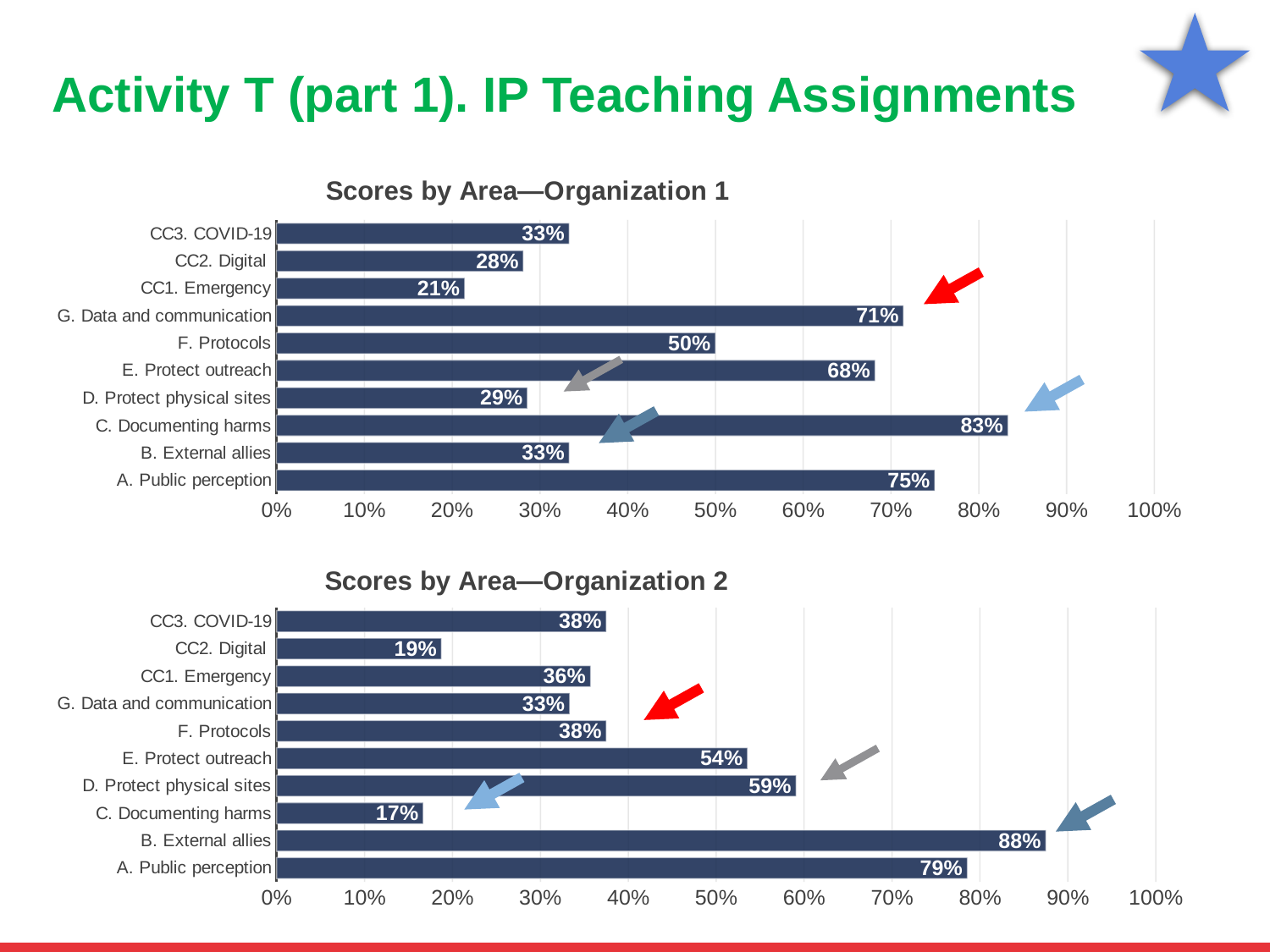
In the 'Scores by Area—Organization 2' chart, what is the value for D. Protect physical sites? 59% In the 'Scores by Area—Organization 2' chart, which is larger, E. Protect outreach or CC1. Emergency? E. Protect outreach In the 'Scores by Area—Organization 1' chart, what is the difference between A. Public perception and G. Data and communication? 4% In the 'Scores by Area—Organization 1' chart, which area has the highest score? C. Documenting harms In the 'Scores by Area—Organization 1' chart, which area has the lowest score? CC1. Emergency What kind of chart is 'Scores by Area—Organization 2'? Bar chart In the 'Scores by Area—Organization 2' chart, which area has the highest score? B. External allies In the 'Scores by Area—Organization 2' chart, what is the difference between B. External allies and A. Public perception? 9% In the 'Scores by Area—Organization 1' chart, how many areas are plotted? 10 In the 'Scores by Area—Organization 2' chart, which area has the lowest score? C. Documenting harms In the 'Scores by Area—Organization 1' chart, what is the value for C. Documenting harms? 83% In the 'Scores by Area—Organization 1' chart, is the value for E. Protect outreach greater or less than 60%? greater